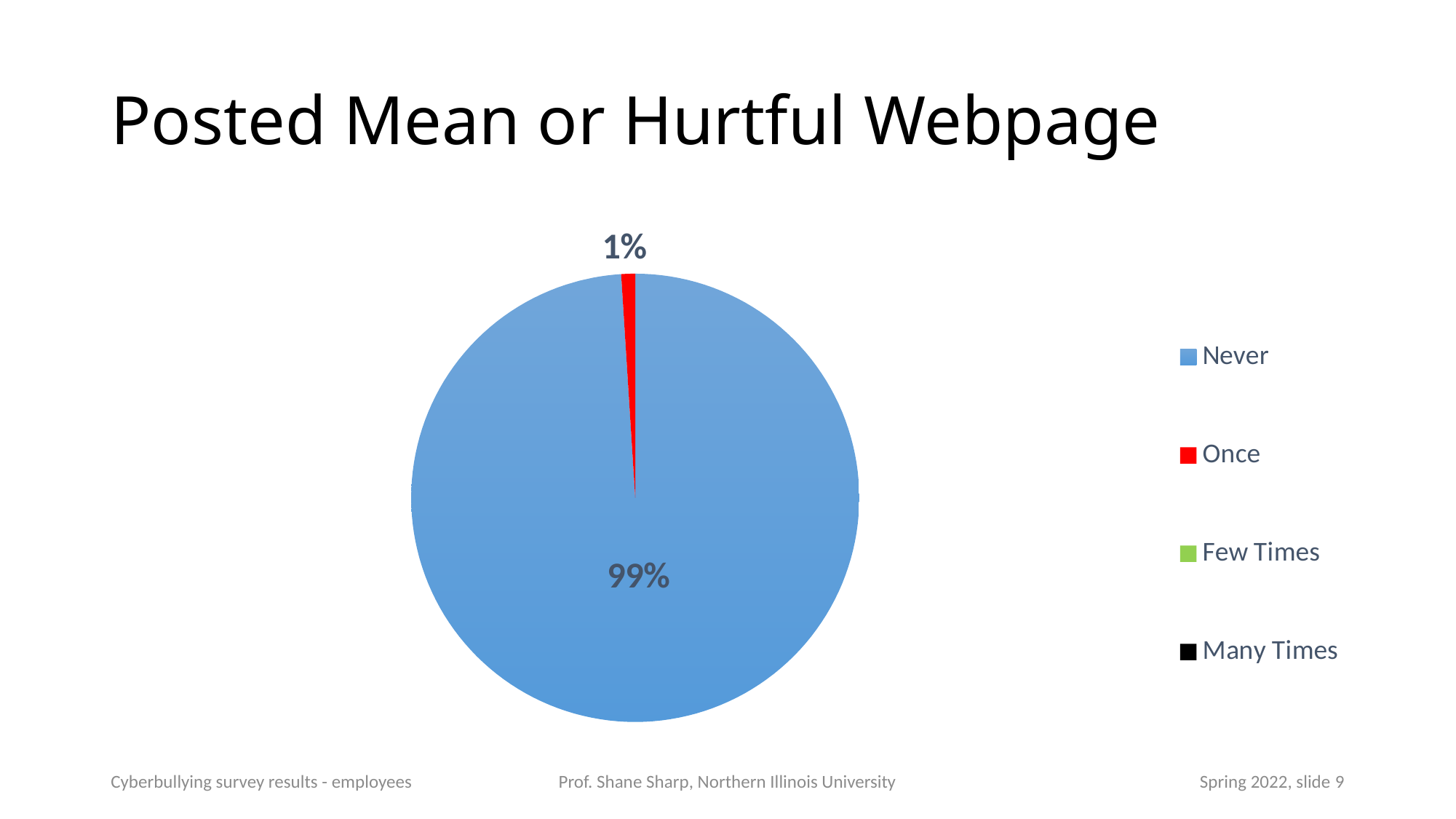
What is the difference between the Never share and the Once share? 98% How many entries does the legend list? 4 Is the share for Never greater or less than 50%? greater What share of the pie does the Never slice take? 99% Which is larger, the Never slice or the Once slice? Never Which category has the largest slice of the pie? Never What kind of chart is shown on the slide? pie chart What colour is the Once slice in the pie chart? red How many slices with data labels are visible in the pie chart? 2 What share of the pie does the Once slice take? 1% What is the title of the chart? Posted Mean or Hurtful Webpage